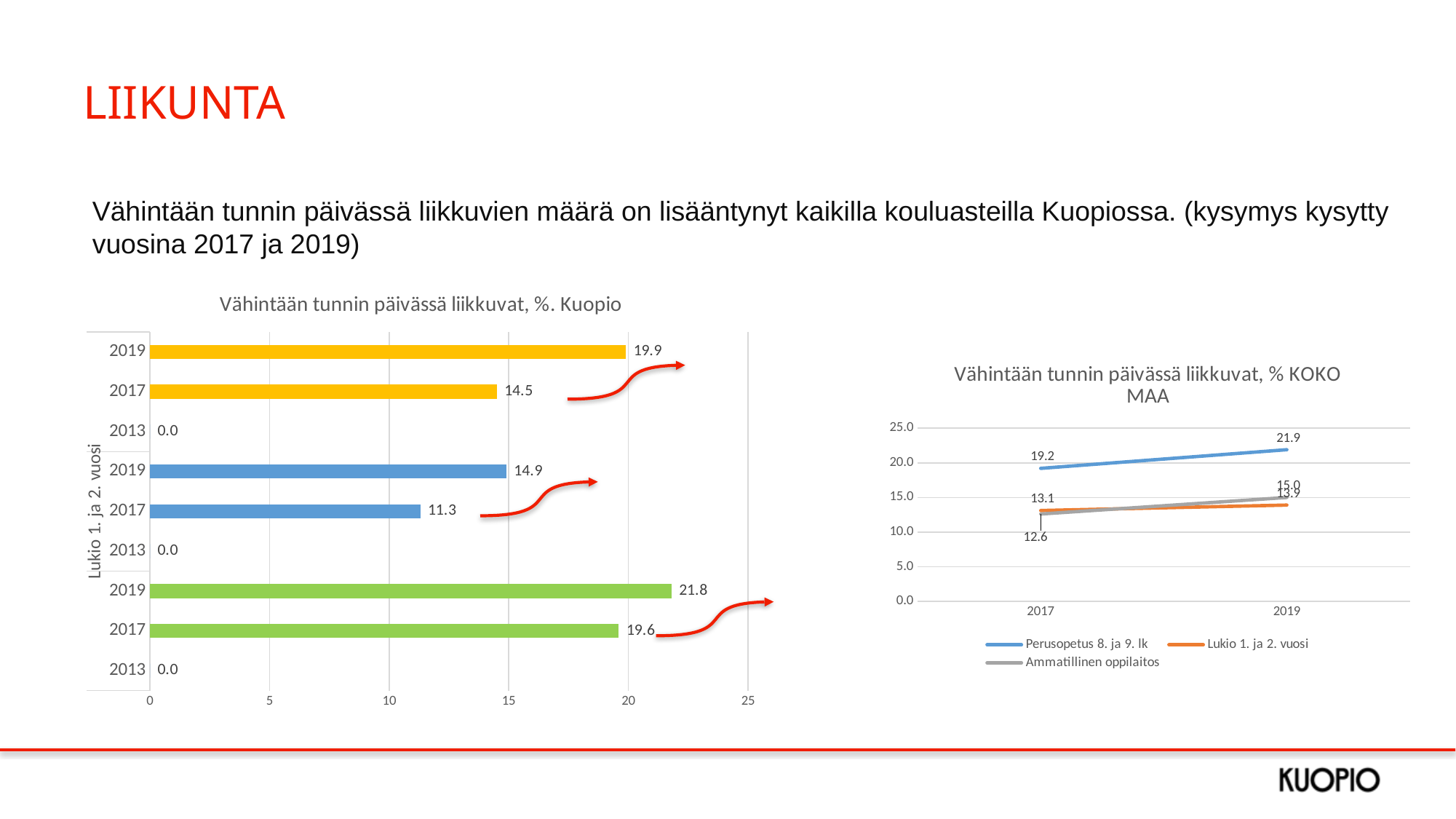
How many series does the legend of the right chart 'Vähintään tunnin päivässä liikkuvat, % KOKO MAA' list? 3 In the right chart 'Vähintään tunnin päivässä liikkuvat, % KOKO MAA', does the value for Perusopetus 8. ja 9. lk rise or fall from 2017 to 2019? Rise In the right chart 'Vähintään tunnin päivässä liikkuvat, % KOKO MAA', what is the value for Ammatillinen oppilaitos in 2019? 15.0 In the left chart 'Vähintään tunnin päivässä liikkuvat, %. Kuopio', which is larger: the blue bar for 2019 or the yellow bar for 2017? Blue bar for 2019 (14.9) In the left chart 'Vähintään tunnin päivässä liikkuvat, %. Kuopio', what is the value of the blue bar for 2017? 11.3 In the left chart 'Vähintään tunnin päivässä liikkuvat, %. Kuopio', which bar has the highest value? Green 2019 (21.8) What kind of chart is the left chart 'Vähintään tunnin päivässä liikkuvat, %. Kuopio'? Bar chart In the left chart 'Vähintään tunnin päivässä liikkuvat, %. Kuopio', what is the difference between the green bars for 2019 and 2017? 2.2 In the right chart 'Vähintään tunnin päivässä liikkuvat, % KOKO MAA', what is the value for Perusopetus 8. ja 9. lk in 2019? 21.9 In the left chart 'Vähintään tunnin päivässä liikkuvat, %. Kuopio', what is the difference between the yellow bars for 2019 and 2017? 5.4 In the left chart 'Vähintään tunnin päivässä liikkuvat, %. Kuopio', what is the value of the green bar for 2019? 21.8 In the left chart 'Vähintään tunnin päivässä liikkuvat, %. Kuopio', what is the value of the yellow bar for 2019? 19.9